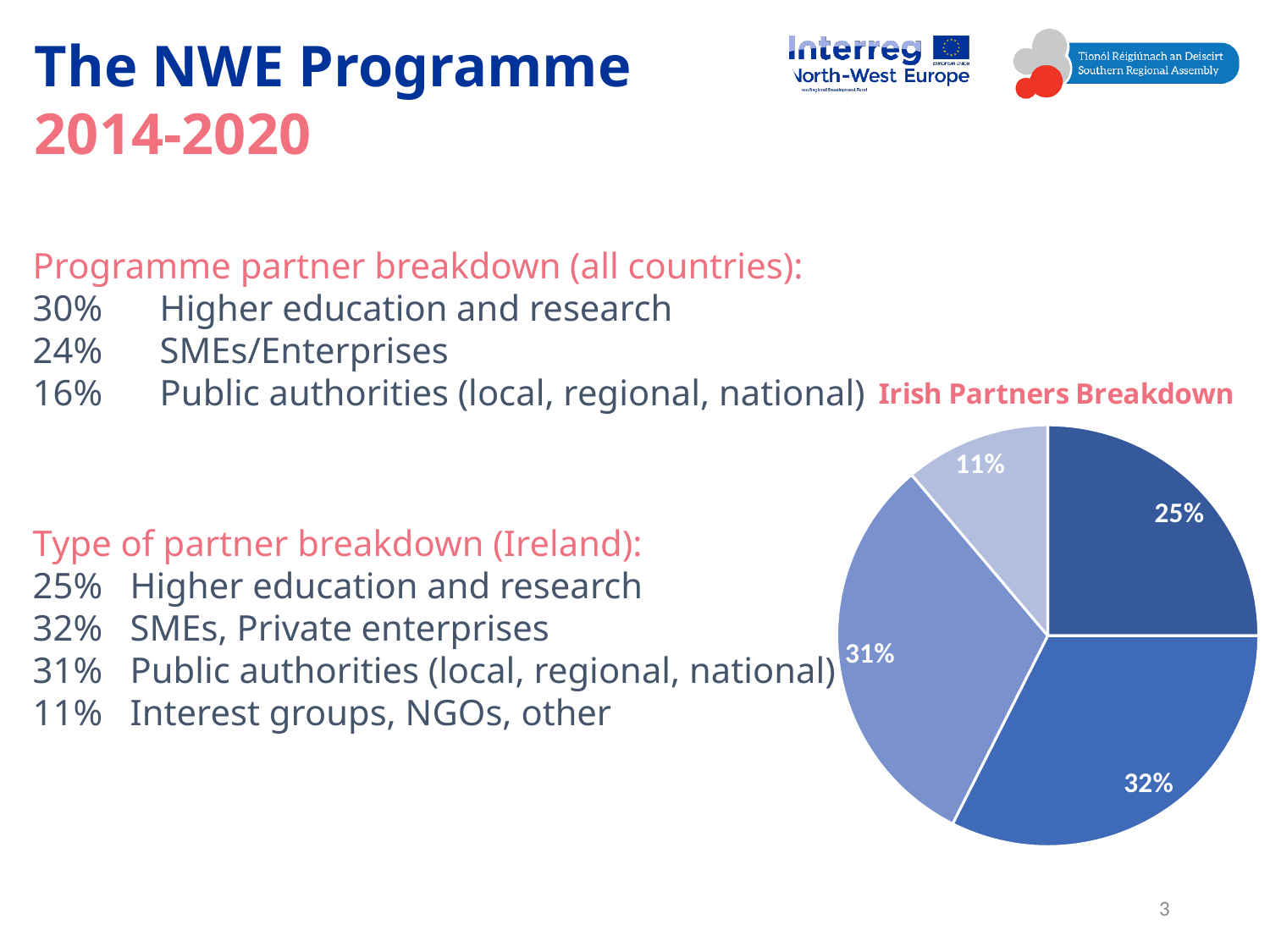
How many slices does the "Irish Partners Breakdown" pie chart have? 4 According to the slide, what share of Irish partners are Public authorities (local, regional, national) in the "Irish Partners Breakdown" pie chart? 31% In the "Irish Partners Breakdown" pie chart, what is the difference between the 31% slice and the 11% slice? 20 percentage points In the "Irish Partners Breakdown" pie chart, what do the 25% and 32% slices add up to? 57% In the "Irish Partners Breakdown" pie chart, what is the difference between the 32% slice and the 25% slice? 7 percentage points What is the value of the smallest slice in the "Irish Partners Breakdown" pie chart? 11% What is the value of the largest slice in the "Irish Partners Breakdown" pie chart? 32% In the "Irish Partners Breakdown" pie chart, which is larger: the 31% slice or the 25% slice? 31% According to the slide, what share of Irish partners are Interest groups, NGOs, other in the "Irish Partners Breakdown" pie chart? 11% According to the slide, what share of Irish partners are SMEs, Private enterprises in the "Irish Partners Breakdown" pie chart? 32% What is the title of the pie chart on the slide? Irish Partners Breakdown What kind of chart is the "Irish Partners Breakdown" chart? pie chart